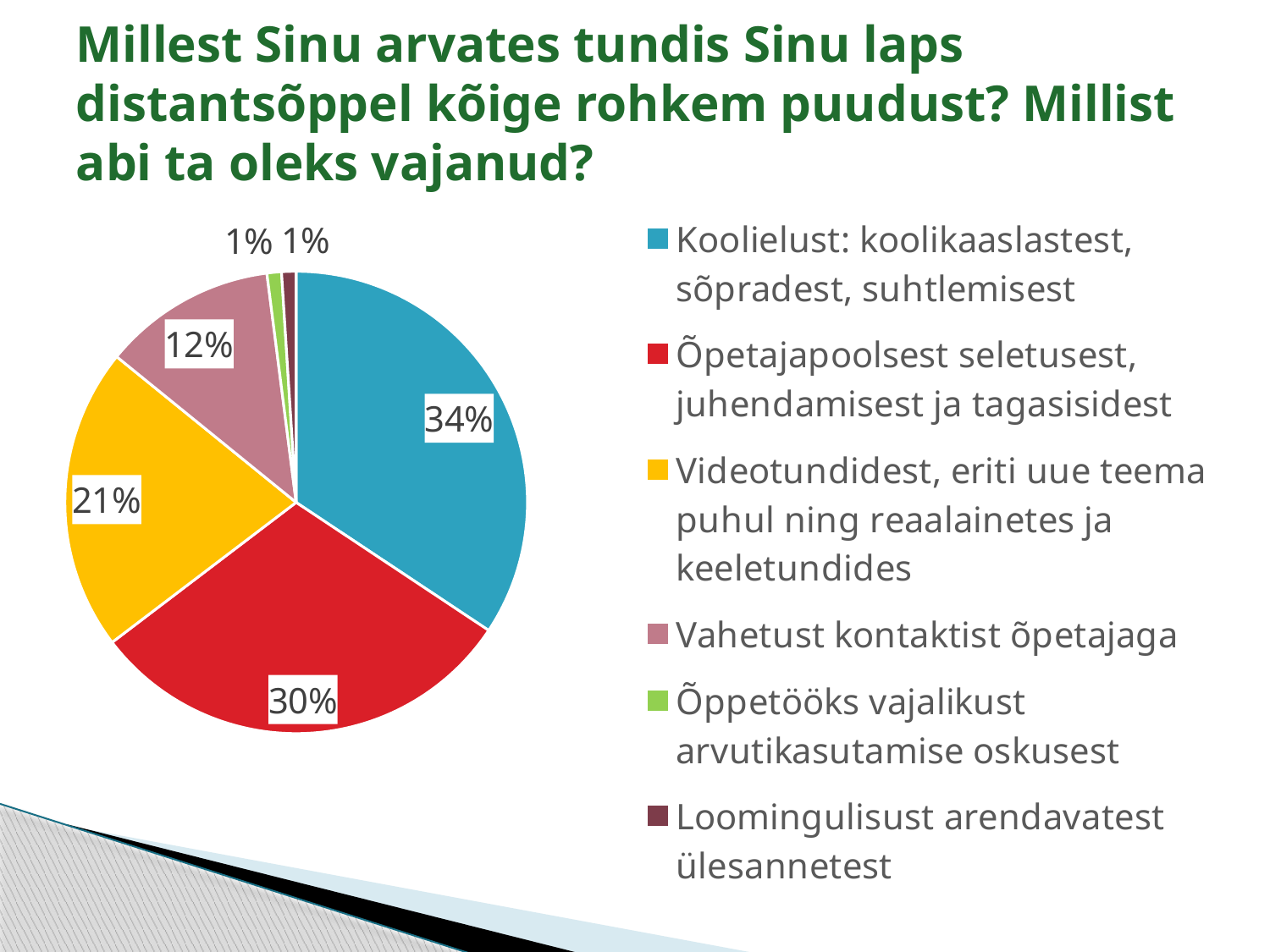
What is the value shown for "Videotundidest, eriti uue teema puhul ning reaalainetes ja keeletundides"? 21% How many categories does the legend list? 6 Which is larger: the slice for "Videotundidest" or the slice for "Vahetust kontaktist õpetajaga"? Videotundidest, eriti uue teema puhul ning reaalainetes ja keeletundides What colour is the slice for "Videotundidest, eriti uue teema puhul ning reaalainetes ja keeletundides"? yellow Which category has the largest slice of the pie? Koolielust: koolikaaslastest, sõpradest, suhtlemisest What is the combined share of the two 1% slices? 2% What is the difference in percentage points between the "Koolielust" slice and the "Õpetajapoolsest seletusest" slice? 4 What share of the pie does "Õpetajapoolsest seletusest, juhendamisest ja tagasisidest" have? 30% What percentage is shown for "Loomingulisust arendavatest ülesannetest"? 1% What percentage is shown for "Vahetust kontaktist õpetajaga"? 12% What percentage of the pie is labelled for "Koolielust: koolikaaslastest, sõpradest, suhtlemisest"? 34% What type of chart is shown on the slide? pie chart